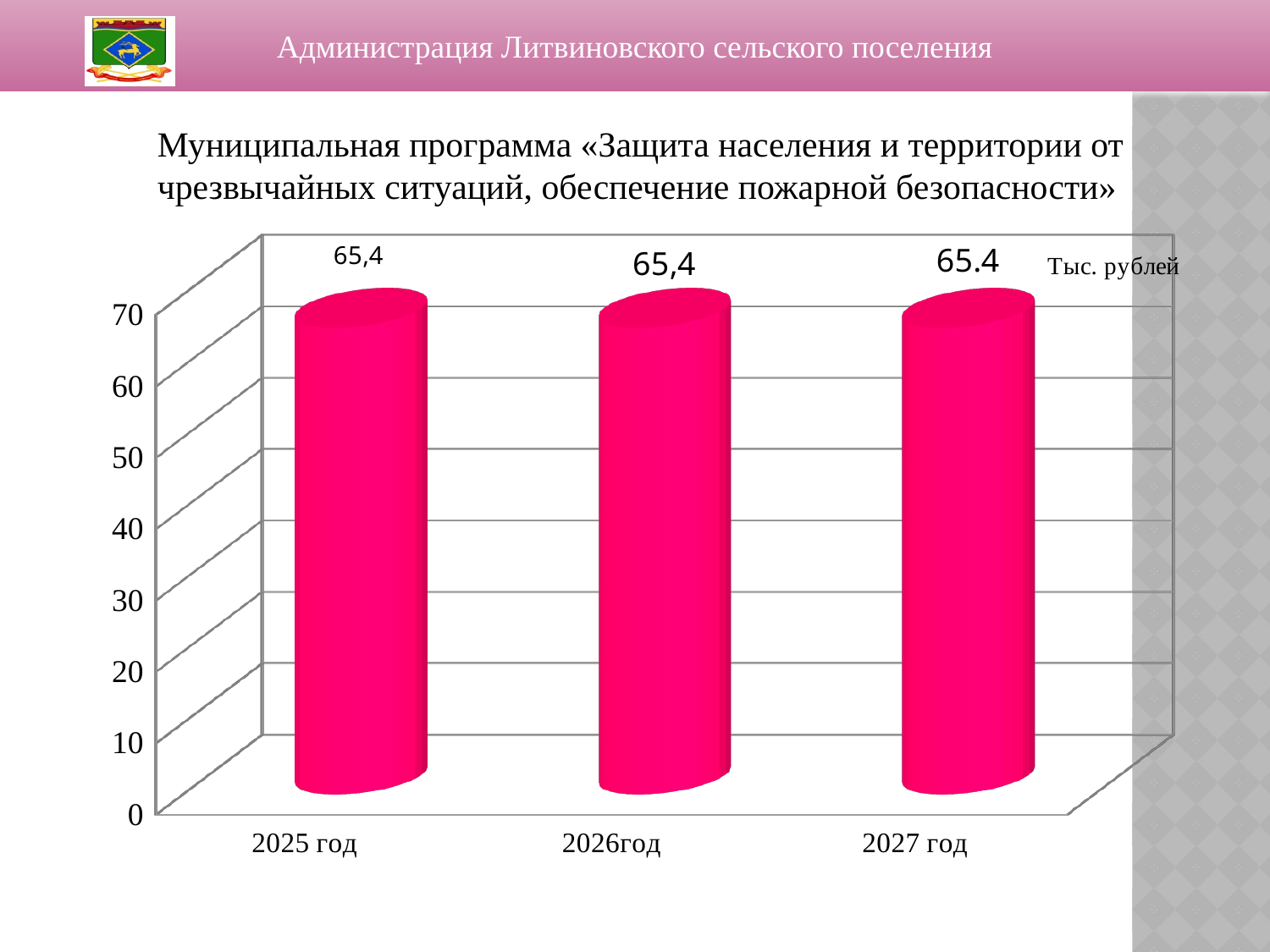
Do the values rise, fall, or stay the same from 2025 год to 2027 год? stay the same What is the difference between the values for 2025 год and 2026год? 0 Is the value for 2027 год greater or less than 70? less What is the value for 2026год? 65,4 How many categories (years) are plotted on the chart? 3 What is the highest tick value shown on the vertical axis? 70 What kind of chart is shown on the slide? bar chart Is the value for 2025 год greater or less than 60? greater What unit of measurement is indicated on the chart? Тыс. рублей What is the value shown above the bar for 2027 год? 65.4 What is the value for 2025 год? 65,4